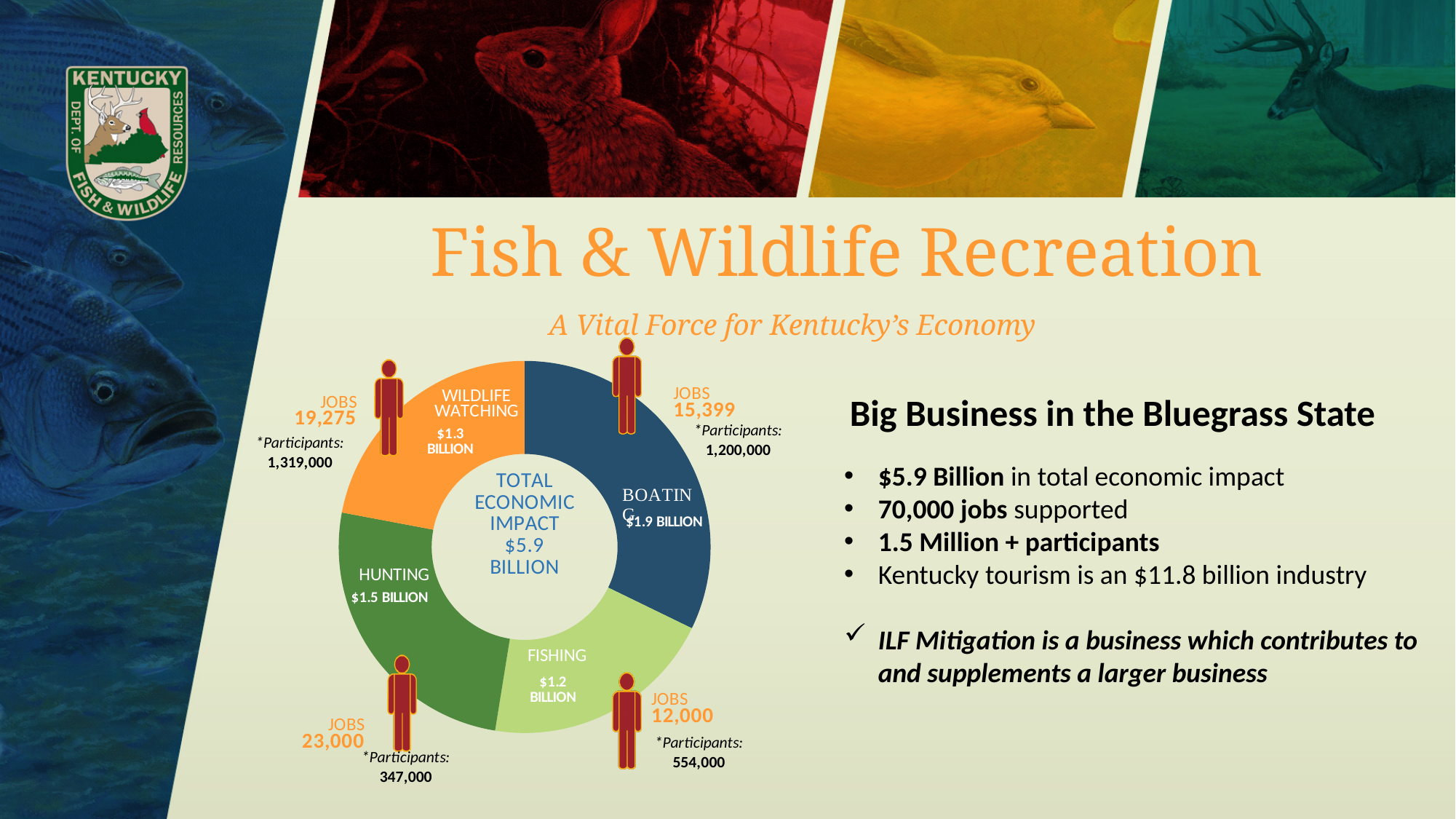
Which has a larger economic impact, Hunting or Wildlife Watching? Hunting What is the economic impact value shown for Hunting? $1.5 BILLION How many jobs are shown next to the Hunting segment? 23,000 Which activity has the smallest economic impact in the donut chart? Fishing How many activity segments does the donut chart have? 4 What is the economic impact value shown for Boating? $1.9 BILLION Which activity has the largest economic impact in the donut chart? Boating What total economic impact is shown in the center of the donut chart? $5.9 BILLION What is the economic impact value shown for Wildlife Watching? $1.3 BILLION What kind of chart is used to show the economic impact by activity? Donut (pie) chart What is the difference in economic impact between Boating and Fishing? $0.7 billion What is the economic impact value shown for Fishing? $1.2 BILLION